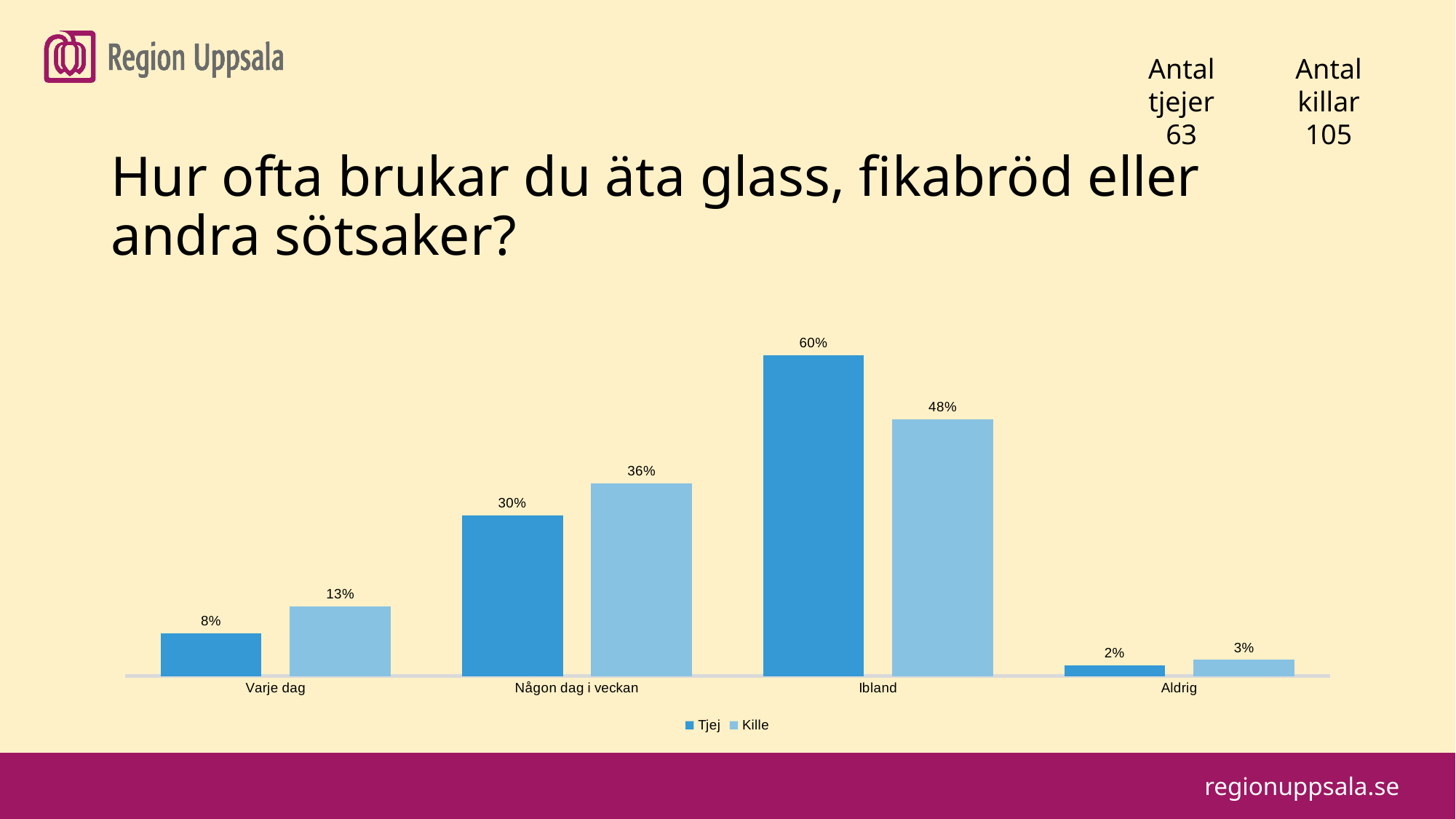
What is the value for Tjej in the Ibland category? 60% What kind of chart is shown on the slide? Bar chart What is the difference between the Kille and Tjej values in the Varje dag category? 5% Which category has the highest value for Tjej? Ibland How many categories are shown on the x axis? 4 How many series does the legend list? 2 What is the value for Kille in the Varje dag category? 13% What is the value for Kille in the Någon dag i veckan category? 36% In the Någon dag i veckan category, which series has the larger value, Tjej or Kille? Kille What are the two series named in the legend? Tjej and Kille What is the difference between the Tjej and Kille values in the Ibland category? 12% Which category has the lowest value for Kille? Aldrig